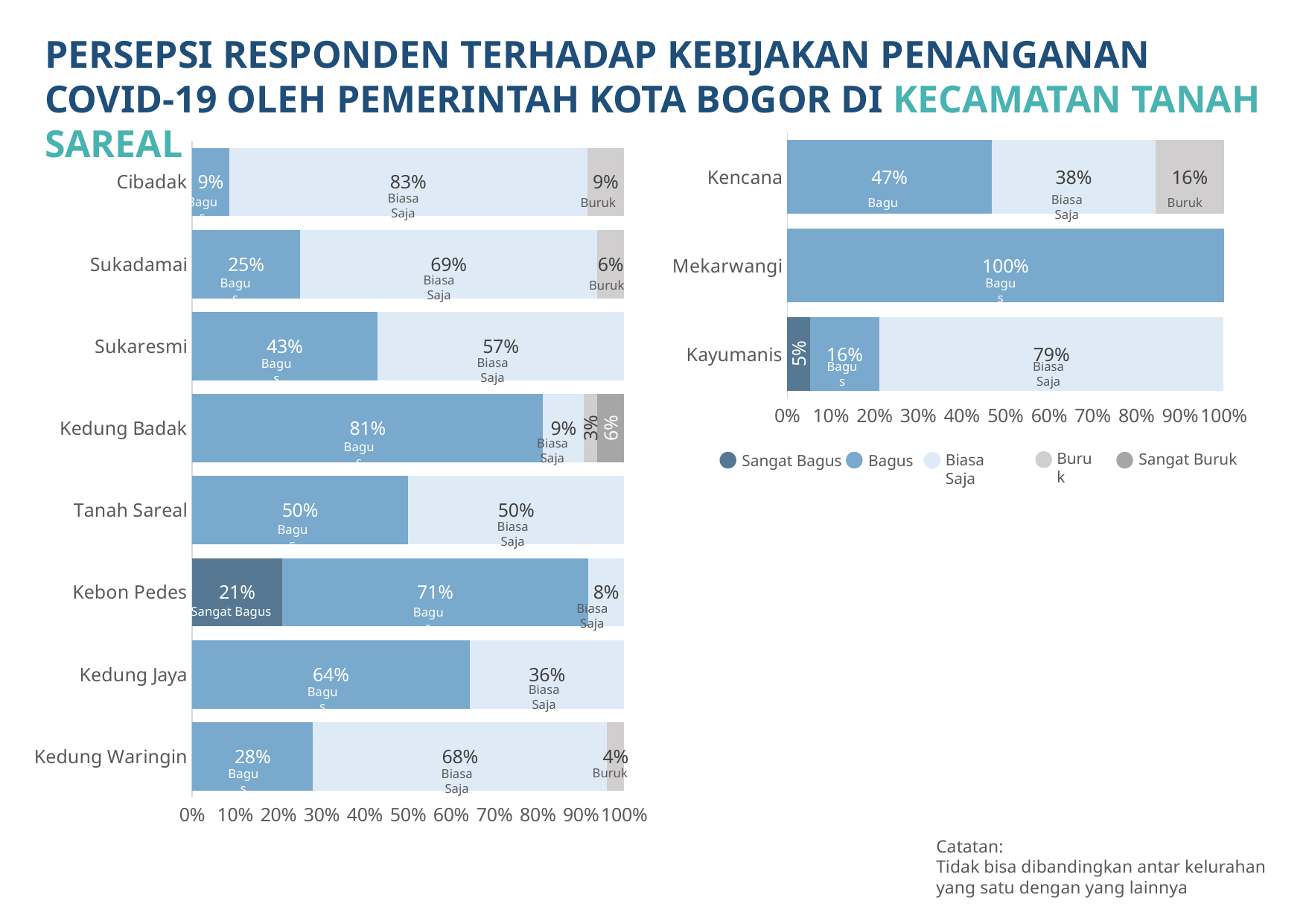
On the right chart, what is the Bagus percentage for Mekarwangi? 100% How many kelurahan are shown on the left chart? 8 On the left chart, what is the difference between the Biasa Saja percentages of Sukadamai and Kedung Jaya? 33% On the left chart, what is the Bagus percentage for Kedung Badak? 81% On the left chart, which kelurahan has the highest Bagus percentage? Kedung Badak On the right chart, which has a larger Buruk share, Kencana or Kayumanis? Kencana On the right chart, what percentage of Kayumanis respondents answered Biasa Saja? 79% On the left chart, which kelurahan has the lowest Bagus percentage? Cibadak How many series does the legend list? 5 On the left chart, what percentage of respondents in Cibadak rated the policy as Biasa Saja? 83% On the left chart, what percentage of Kebon Pedes respondents answered Sangat Bagus? 21% What type of chart is used on the slide? Stacked bar chart